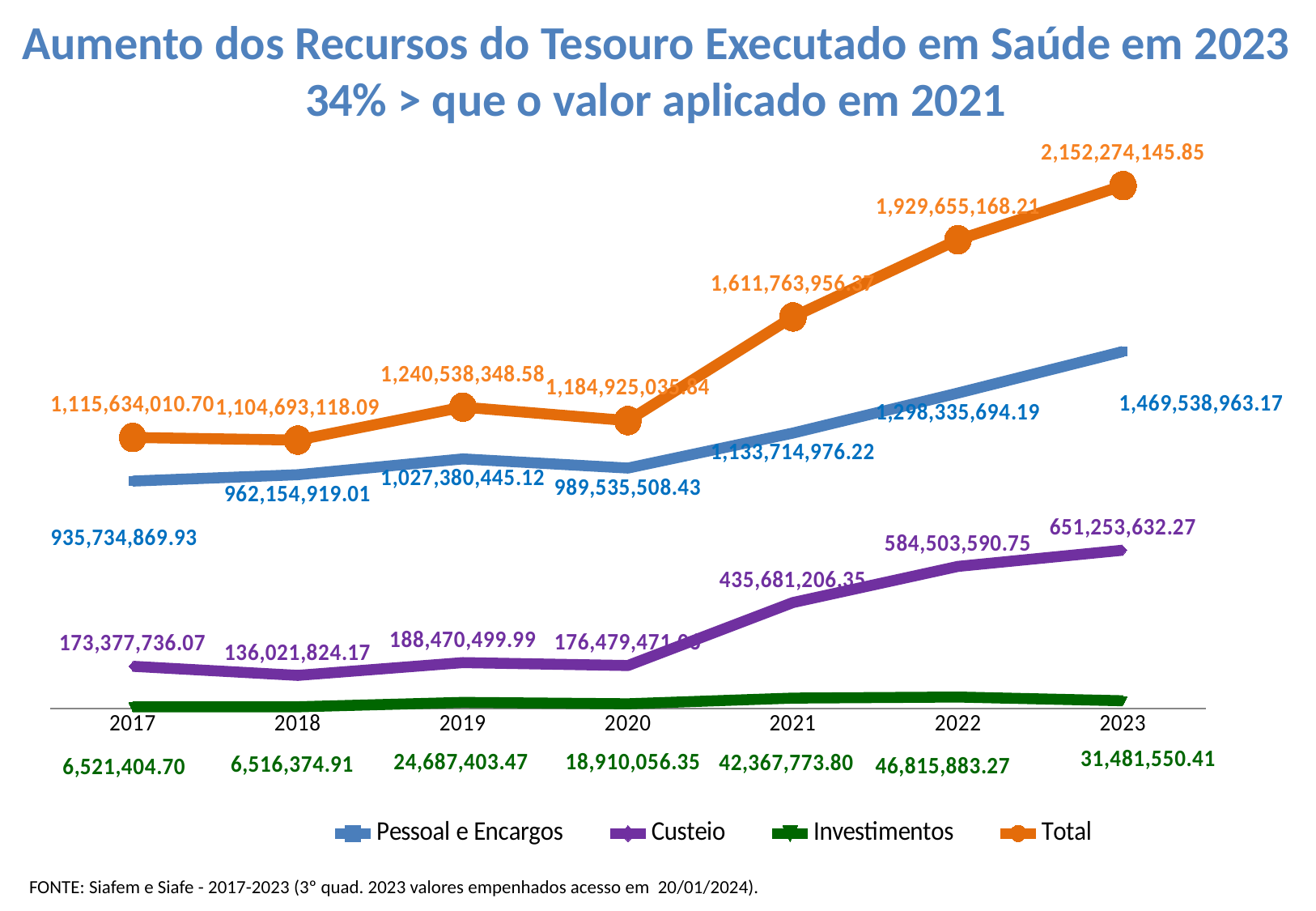
How many series does the legend list? 4 What is the value of Custeio in 2021? 435,681,206.35 In which year is the Custeio series lowest? 2018 What is the value of the Total series in 2022? 1,929,655,168.21 What kind of chart is shown on the slide? Line chart In which year is the Custeio series highest? 2023 What is the difference between Pessoal e Encargos in 2023 and in 2022? 171,203,268.98 What is the value of Pessoal e Encargos in 2017? 935,734,869.93 What is the value of the Total series in 2023? 2,152,274,145.85 Which is larger, Custeio in 2019 or Custeio in 2022? Custeio in 2022 What is the difference between Investimentos in 2022 and in 2017? 40,294,478.57 What is the value of Investimentos in 2019? 24,687,403.47